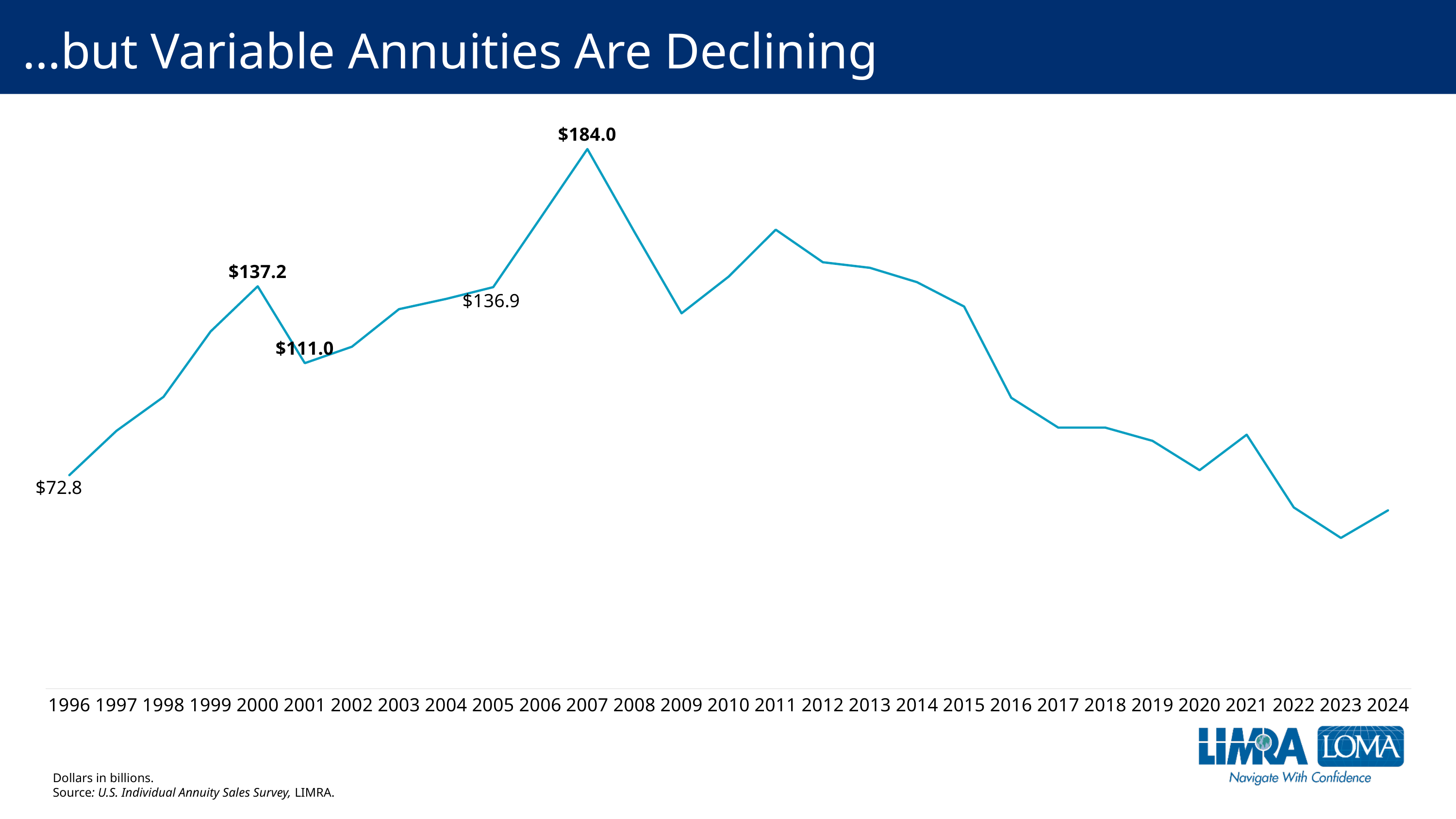
What kind of chart is shown on the slide? line chart What is the value for 1996? $72.8 Which year has the highest value? 2007 What is the value for 2001? $111.0 What is the difference between the values for 2000 and 2001? $26.2 What is the value for 2000? $137.2 Do the values rise or fall from 2007 to 2009? fall What is the difference between the values for 2007 and 2000? $46.8 Which year has the larger value, 2009 or 2016? 2009 How many years are plotted on the x axis? 29 What is the value for 2007? $184.0 Which year has the lowest value? 2023